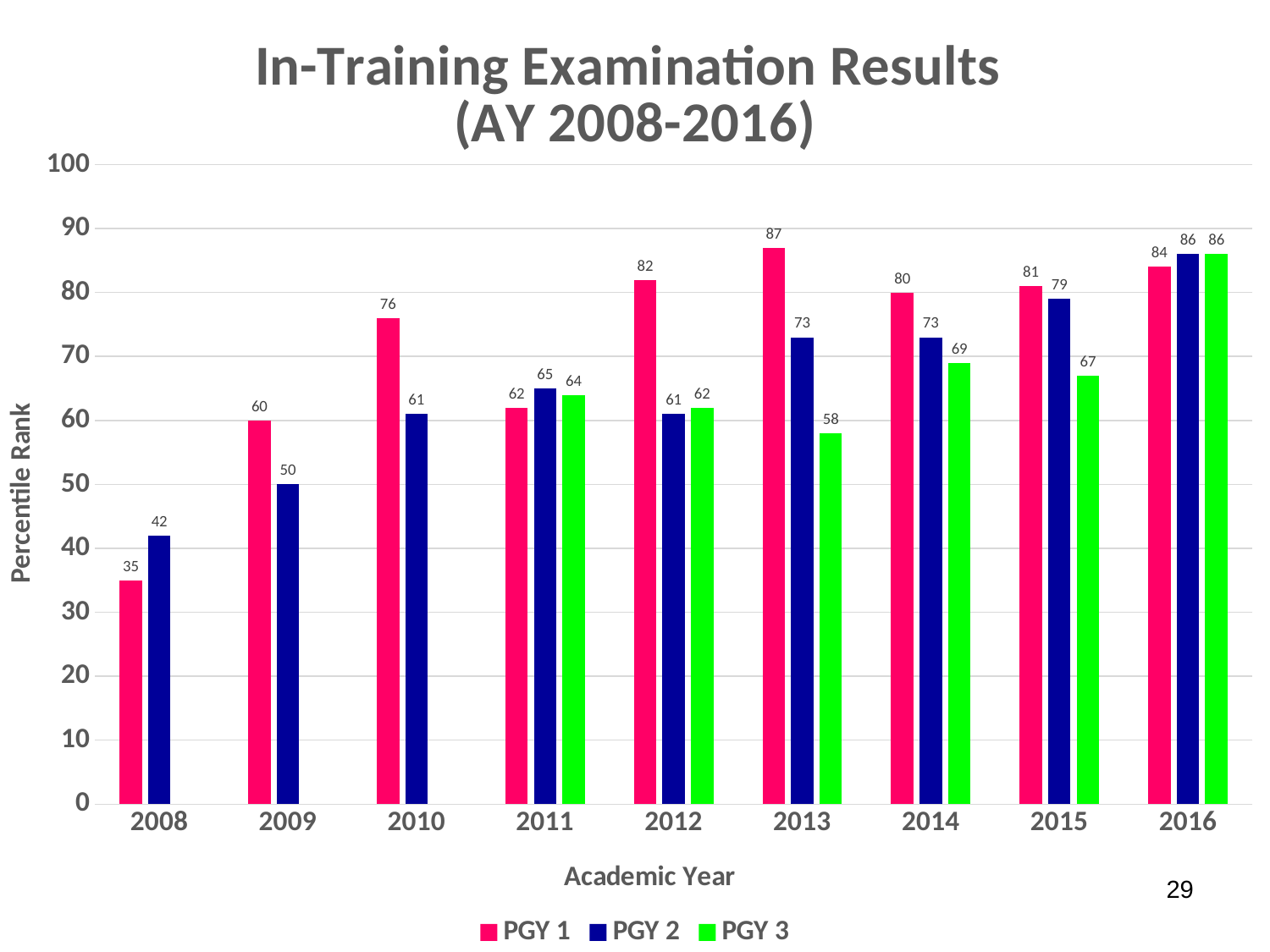
What is the PGY 3 percentile rank for 2011? 64 What is the difference between the PGY 1 and PGY 3 percentile ranks in 2013? 29 What kind of chart is shown on the slide? Bar chart In which academic year is the PGY 2 percentile rank lowest? 2008 What is the title of the chart? In-Training Examination Results (AY 2008-2016) What is the PGY 2 percentile rank for 2008? 42 Which is larger in 2011, the PGY 1 or the PGY 2 percentile rank? PGY 2 Does the PGY 3 percentile rank rise or fall from 2013 to 2016? Rise How many academic years are shown on the x axis? 9 How many series does the legend list? 3 In which academic year is the PGY 1 percentile rank highest? 2013 What is the PGY 1 percentile rank for 2013? 87